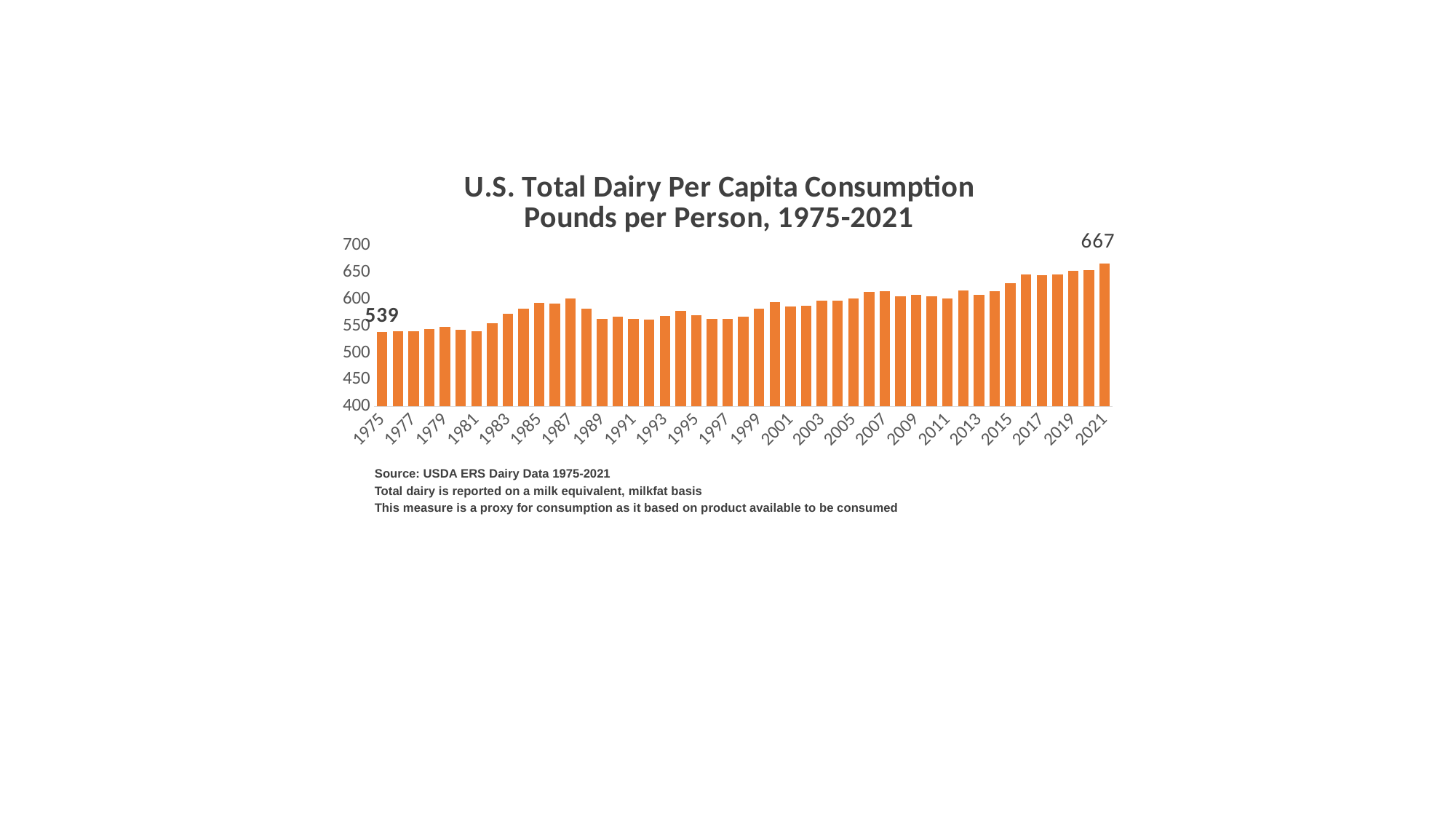
Is the value for 1995 greater or less than 600? less Do the values generally rise or fall from 1975 to 2021? rise Which year has the highest value? 2021 Which is larger, the value for 2021 or the value for 1975? 2021 What is the value for 1975? 539 What is the difference between the values for 2021 and 1975? 128 What kind of chart is shown on the slide? bar chart Is the value for 2017 greater or less than 600? greater How many bars (years) are plotted in the chart? 47 What is the title of the chart? U.S. Total Dairy Per Capita Consumption Pounds per Person, 1975-2021 What is the value for 2021? 667 Is the value for 1987 greater or less than 550? greater